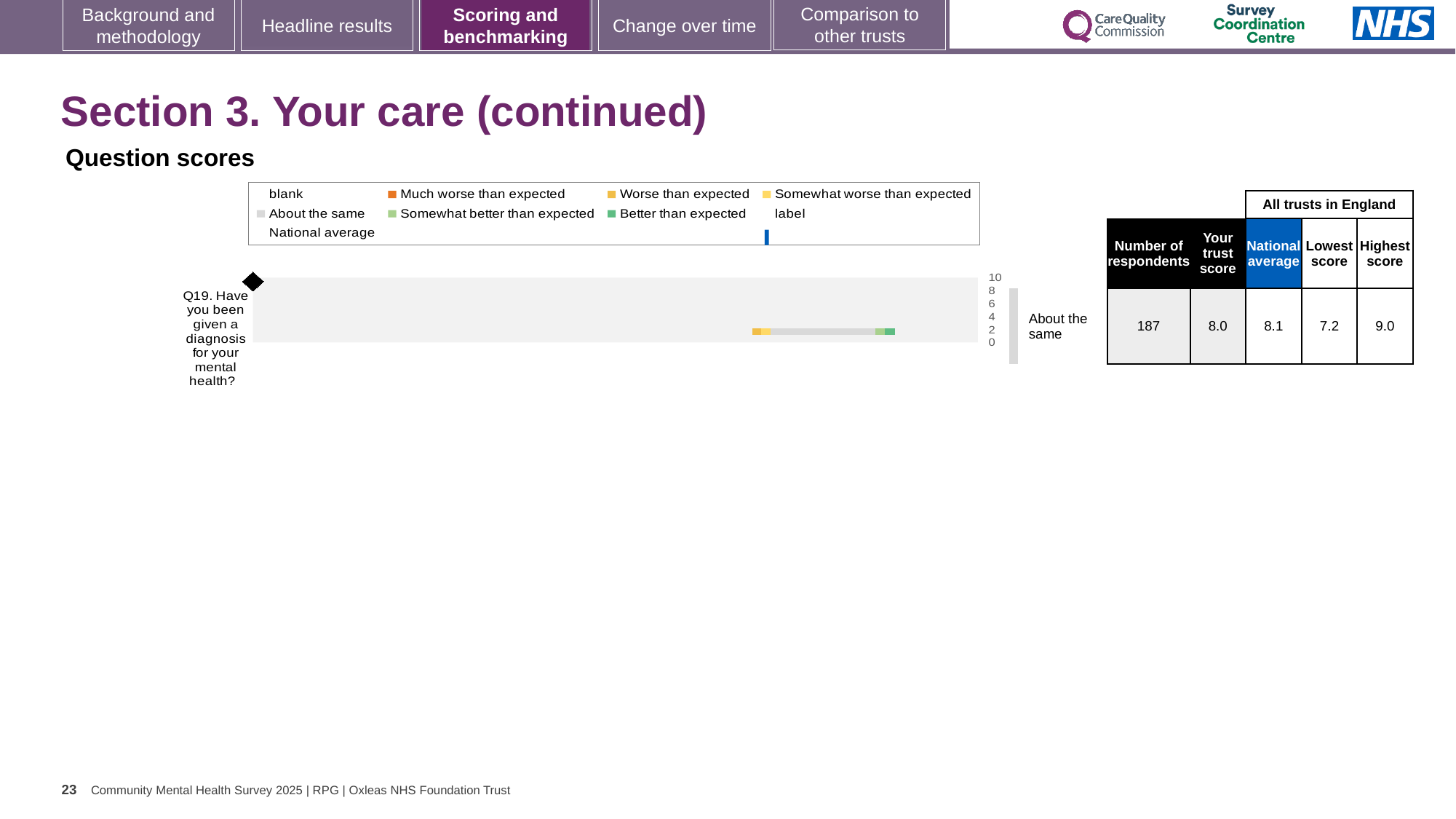
What kind of chart is used to show the Q19 question score? bar chart For Q19, which is larger: your trust score or the national average? national average Which benchmark category is shown next to the bar for Q19? About the same What is the number of respondents for Q19 in the table? 187 What is 'Your trust score' for Q19? 8.0 What is the national average score for Q19? 8.1 What colour does the legend use for 'Better than expected'? green How many questions are plotted in the Question scores chart? 1 Is your trust score for Q19 greater or less than 6? greater What is the lowest score among all trusts in England for Q19? 7.2 What is the highest score among all trusts in England for Q19? 9.0 What is the difference between the highest and lowest scores for Q19? 1.8